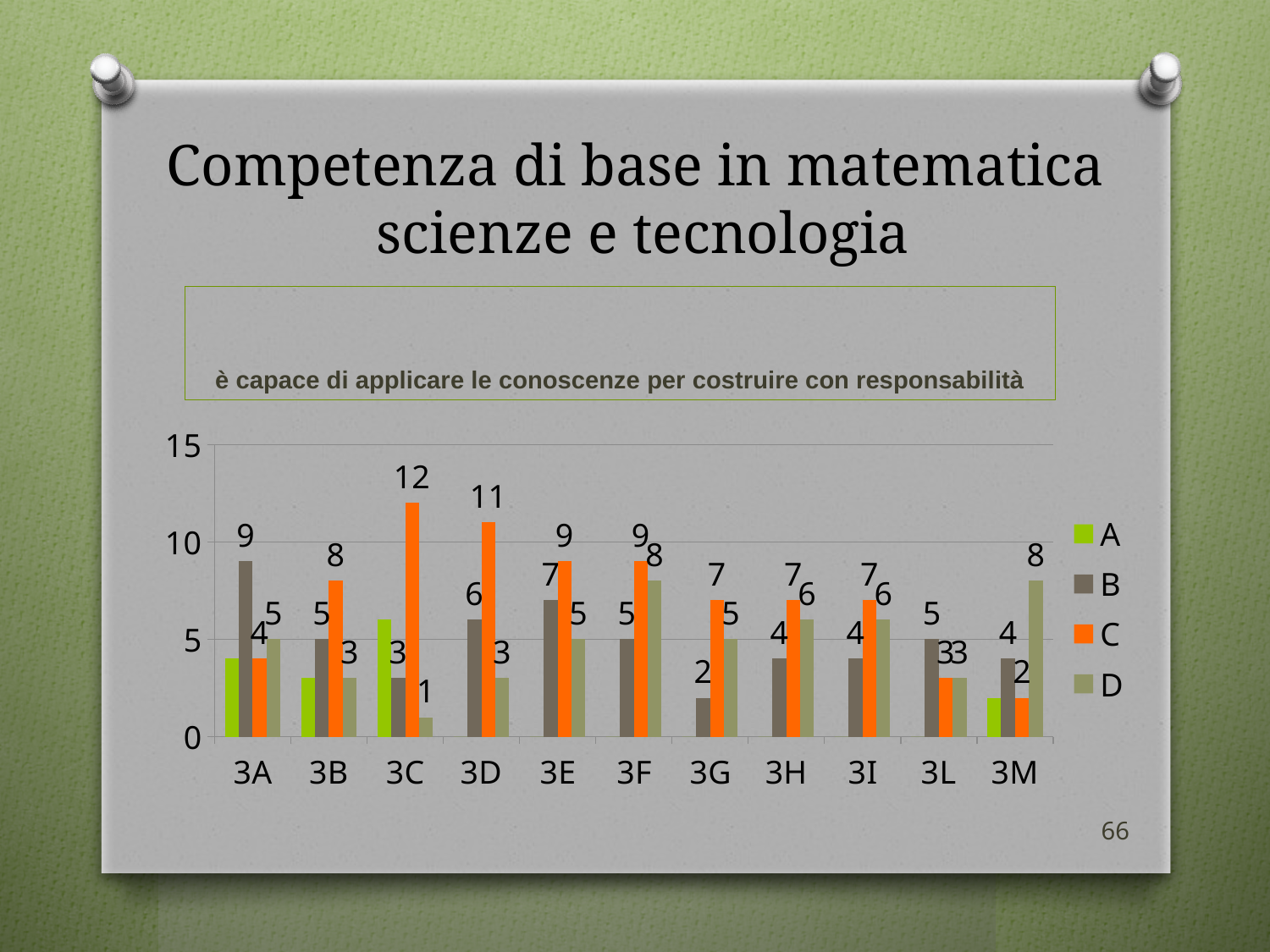
What is the value of series B for 3G? 2 How many series does the legend list? 4 What kind of chart is shown on the slide? bar chart Which category has the highest value for series C? 3C Which is larger: series D for 3F or series D for 3E? 3F What is the difference between series C and series D for 3C? 11 Is the value of series A for 3B greater or less than 5? less What is the value of series C for 3C? 12 How many categories are shown on the x axis? 11 Which category has the lowest value for series D? 3C What is the value of series D for 3M? 8 What is the value of series B for 3A? 9